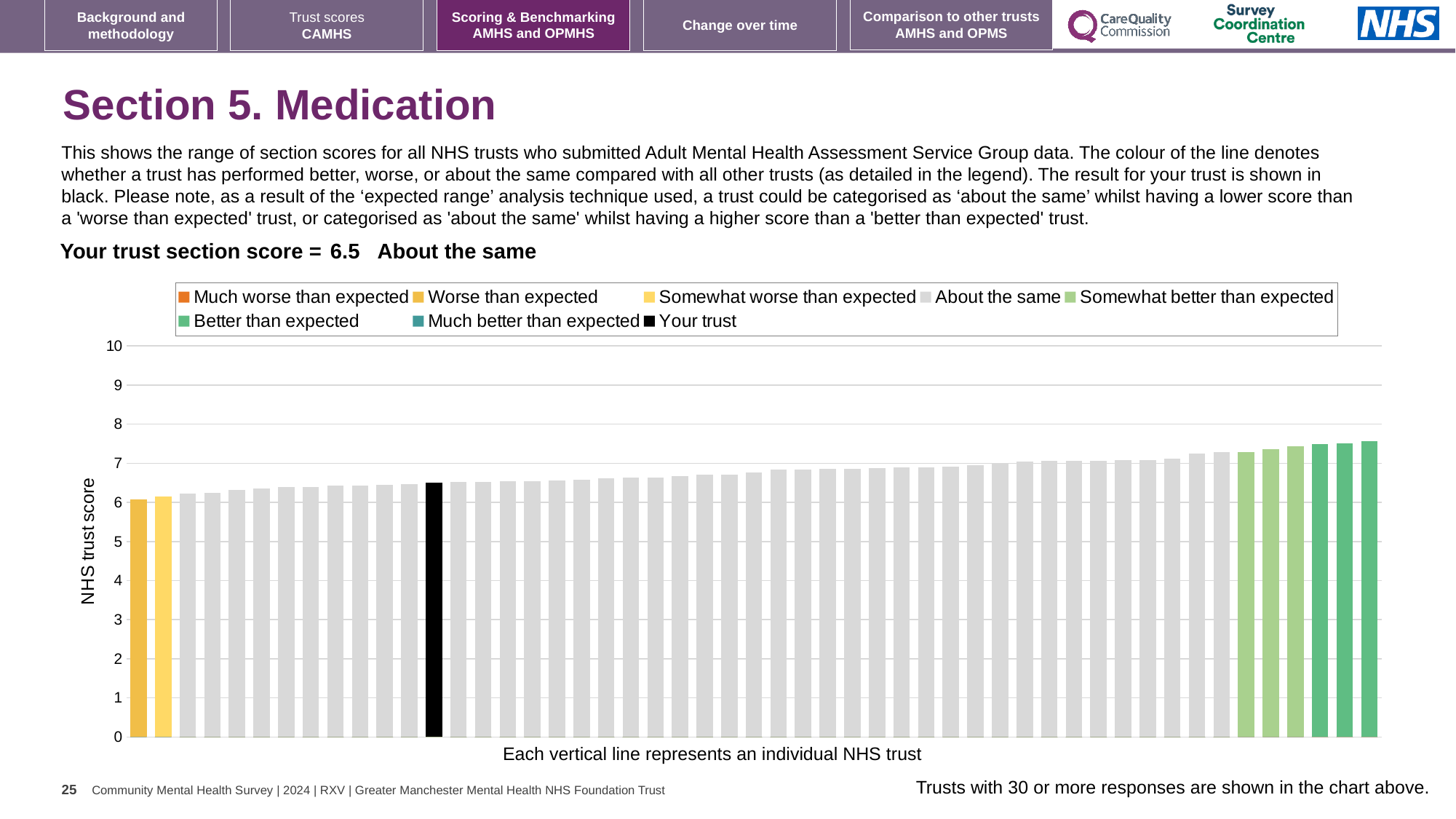
What is the section score for your trust? 6.5 Is the value of the rightmost bar greater or less than 7? greater Is the value of the leftmost bar greater or less than 5? greater Is the value of the rightmost bar greater or less than 8? less Which category is your trust's section score placed in? About the same What kind of chart is shown on the slide? bar chart How many entries does the chart legend list? 8 What colour is the bar representing your trust? black Do the bar values rise or fall from left to right along the x axis? rise What is the label on the vertical axis of the chart? NHS trust score Which is higher, the black 'Your trust' bar or the leftmost bar? the black 'Your trust' bar